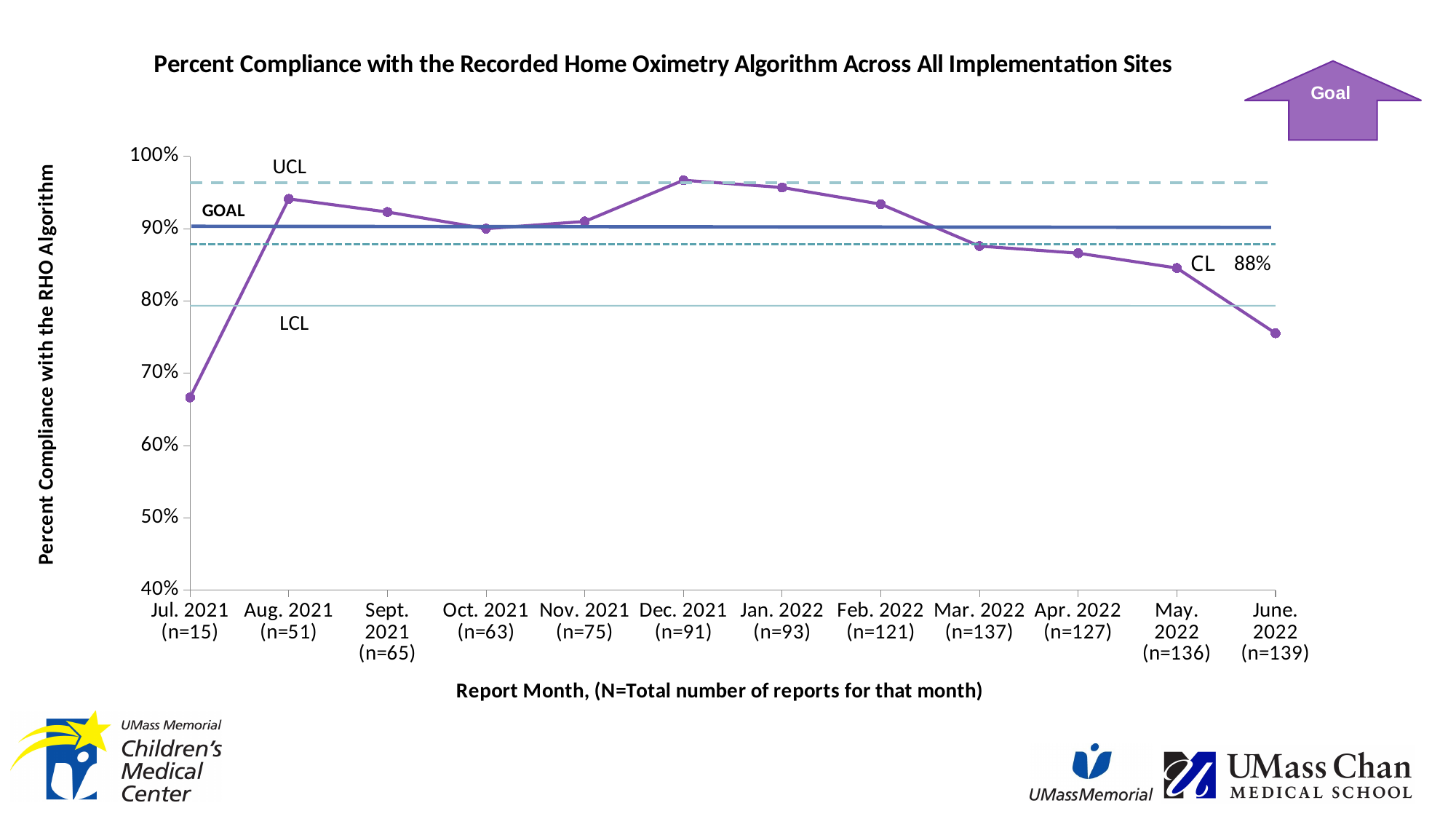
Which month has higher percent compliance, Aug. 2021 or Sept. 2021? Aug. 2021 What is the total number of reports (n) for Dec. 2021 according to the x-axis label? 91 Is the percent compliance for Mar. 2022 greater or less than 90%? less Is the percent compliance for Jul. 2021 greater or less than 70%? less Is the percent compliance for June 2022 greater or less than 80%? less What kind of chart is shown on the slide? line chart Which month has higher percent compliance, Jul. 2021 or June 2022? June 2022 Which month has the lowest percent compliance with the RHO algorithm? Jul. 2021 What value is labeled for the CL (center line) on the chart? 88% How many monthly data points are plotted on the chart? 12 Does percent compliance rise or fall from Feb. 2022 to June 2022? fall